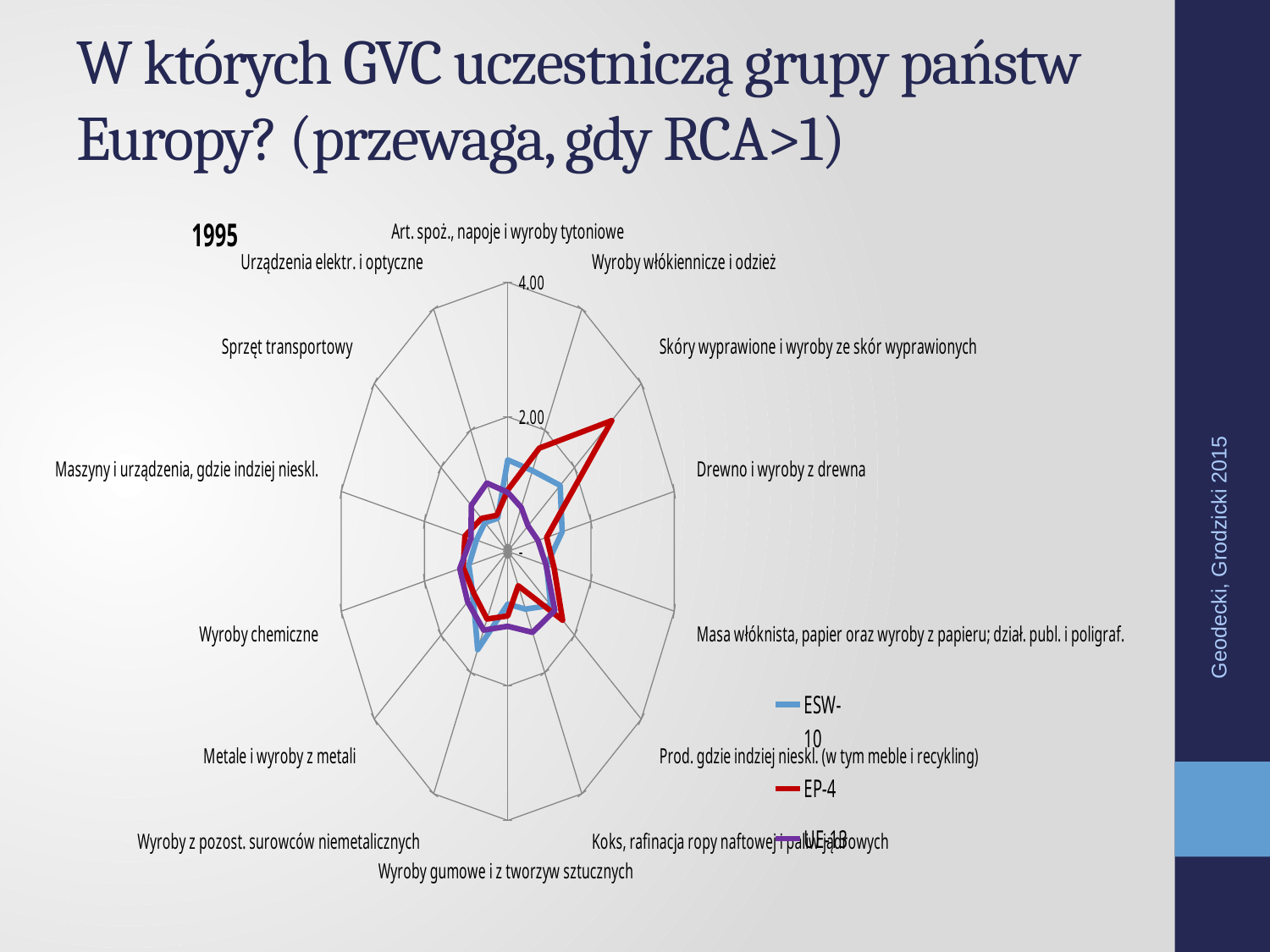
How many categories (axes) does the radar chart have? 14 Is the ESW-10 value for Art. spoż., napoje i wyroby tytoniowe greater or less than 2.00? less Is the UE-13 value for Skóry wyprawione i wyroby ze skór wyprawionych greater or less than 2.00? less What kind of chart is shown on the slide? radar chart How many series does the legend list? 3 Is the EP-4 value for Skóry wyprawione i wyroby ze skór wyprawionych greater or less than 2.00? greater Which year is shown in the chart's label? 1995 For Skóry wyprawione i wyroby ze skór wyprawionych, which series has the larger value, EP-4 or ESW-10? EP-4 For which category does the EP-4 series reach its highest value? Skóry wyprawione i wyroby ze skór wyprawionych For Wyroby chemiczne, which series has the larger value, ESW-10 or UE-13? UE-13 Which series is drawn in red? EP-4